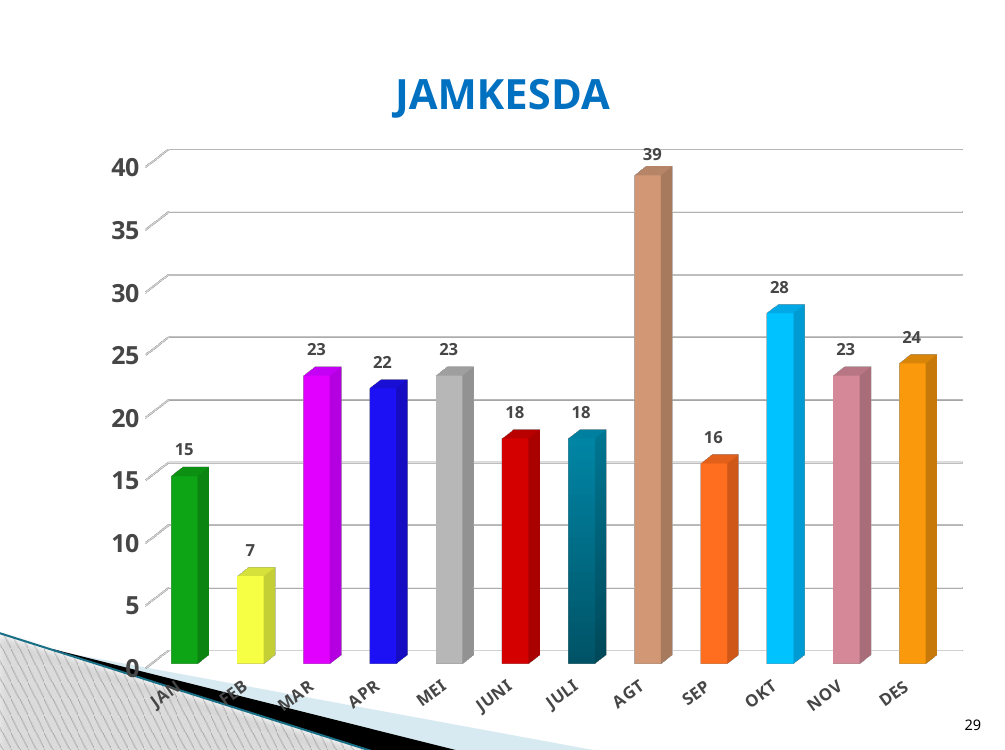
How many months are shown on the x axis of the chart? 12 What is the value for FEB in the JAMKESDA chart? 7 What is the difference between the values for JUNI and JAN? 3 Is the value for JAN greater or less than 10? greater What is the value for AGT in the JAMKESDA chart? 39 What is the title of the chart? JAMKESDA Which month has the lowest value in the JAMKESDA chart? FEB What kind of chart is shown on the slide? bar chart What is the difference between the values for AGT and SEP? 23 Which month has the highest value in the JAMKESDA chart? AGT Which is larger, the value for DES or the value for NOV? DES What is the value for OKT in the JAMKESDA chart? 28